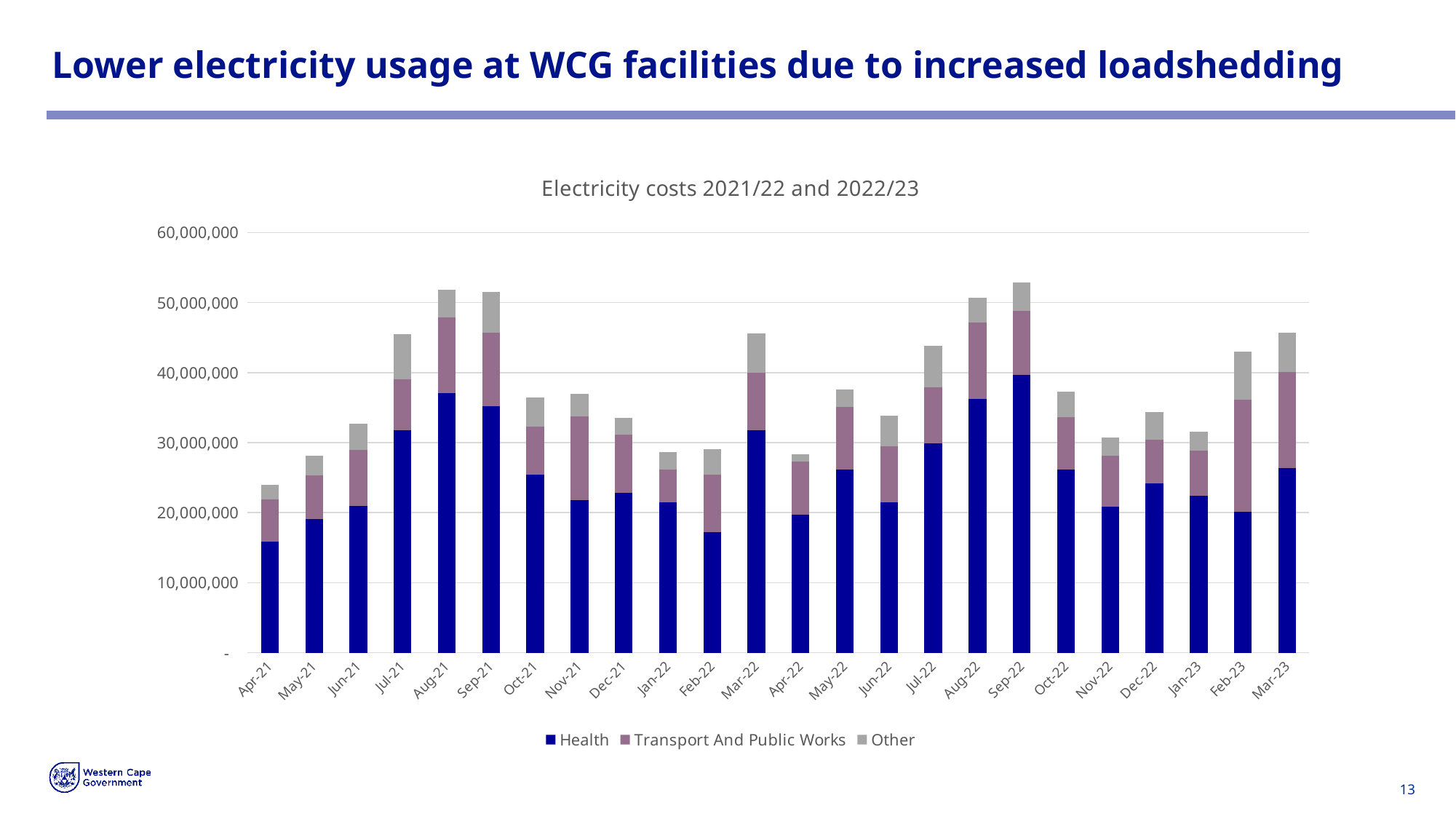
Which is larger, the total for Mar-22 or the total for Feb-22? Mar-22 How many series does the legend list? 3 What kind of chart is shown on the slide? Stacked bar chart Which month has the highest Health value? Sep-22 Which series are listed in the legend? Health, Transport And Public Works, Other How many months are shown on the x axis? 24 Is the Health value for Feb-22 greater or less than 20,000,000? less Is the total for Mar-23 greater or less than 40,000,000? greater Which month has the lowest total electricity cost? Apr-21 Is the total for Sep-22 greater or less than 50,000,000? greater What is the title of the chart? Electricity costs 2021/22 and 2022/23 Do the total electricity costs rise or fall from Apr-21 to Aug-21? rise